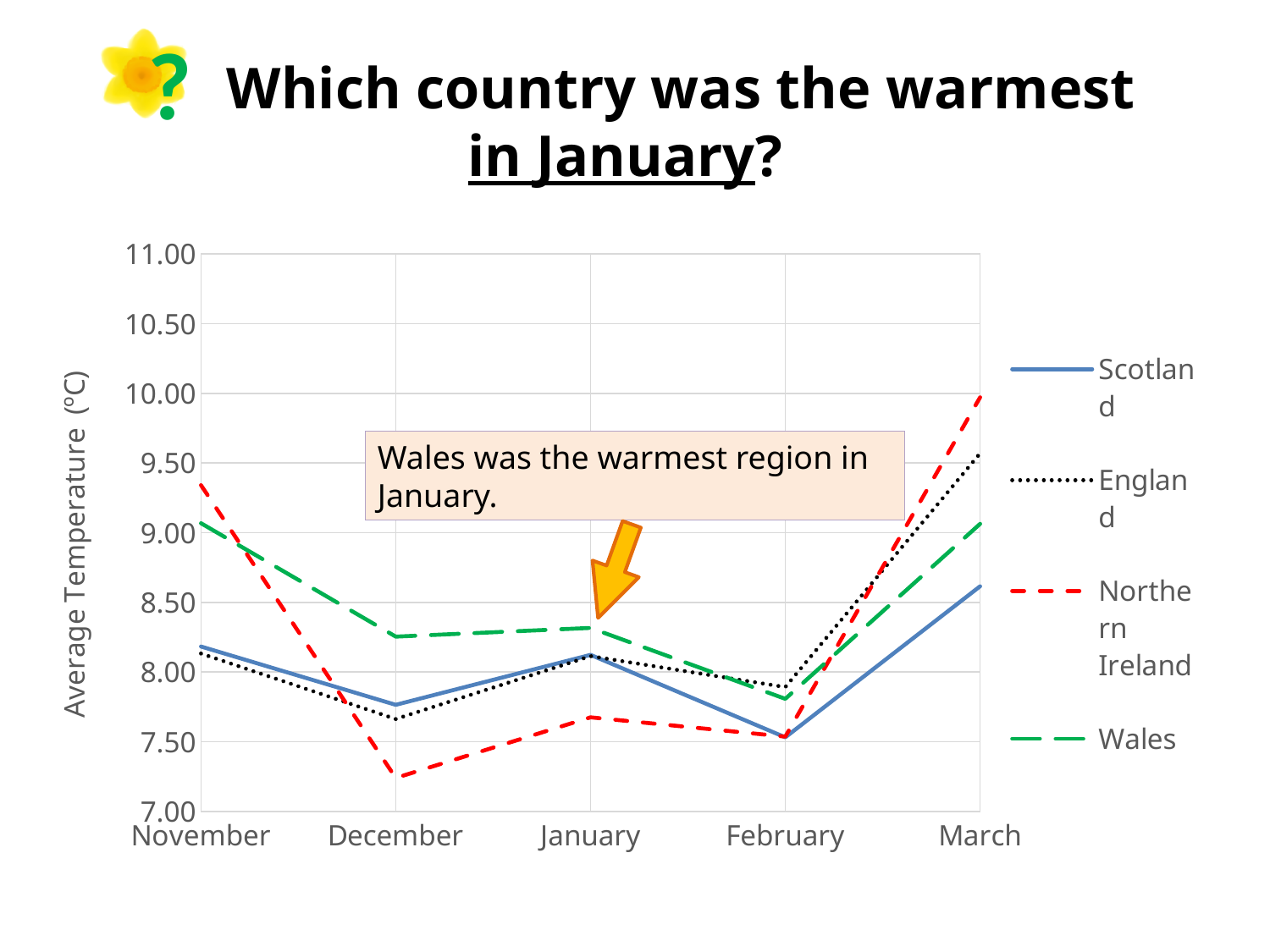
In December, which is higher: Wales or Northern Ireland? Wales Does the Northern Ireland line rise or fall from November to December? fall How many months are shown on the x axis? 5 How many series does the legend list? 4 Which country has the lowest average temperature in December? Northern Ireland Which country has the highest average temperature in March? Northern Ireland Is the value for Northern Ireland in December greater or less than 7.50? less Is the value for Wales in January greater or less than 8.00? greater What is the title of the y axis? Average Temperature (ºC) What kind of chart is shown on the slide? line chart Which country has the highest average temperature in January? Wales Which country has the lowest average temperature in January? Northern Ireland